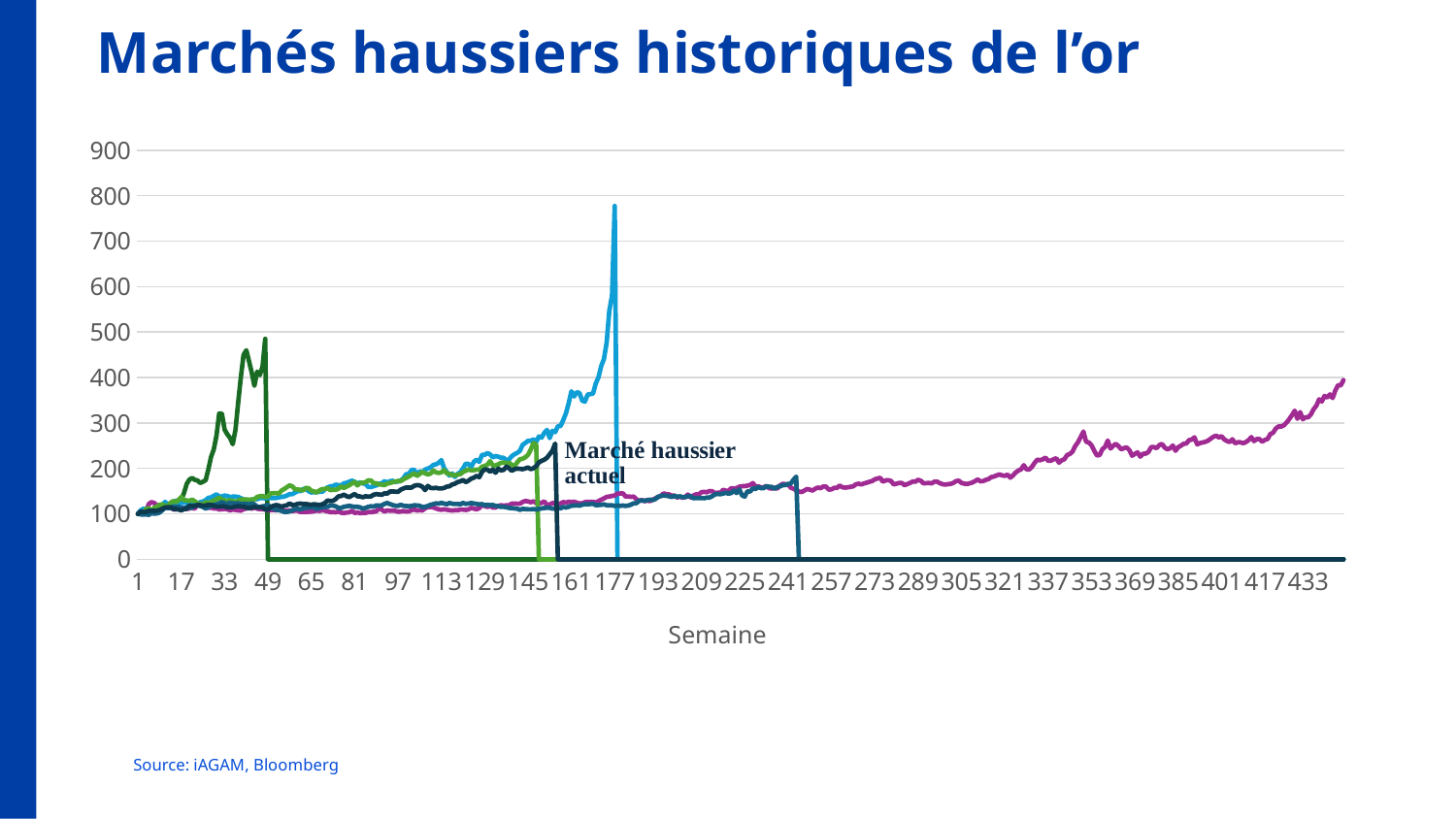
What is the label of the x axis? Semaine Is the peak value of the light blue line greater or less than 700? greater What is the highest value shown on the y axis? 900 Is the peak value of the dark green line greater or less than 400? greater Which coloured line reaches the highest value on the chart? the light blue line Is the final value of the magenta line (around week 433) greater or less than 300? greater What is the title of the chart? Marchés haussiers historiques de l'or Which coloured line extends furthest along the x axis? the magenta line Does the magenta line rise or fall overall from week 257 to week 433? rise What kind of chart is shown on the slide? line chart Is the peak of the light blue line higher or lower than the peak of the dark green line? higher